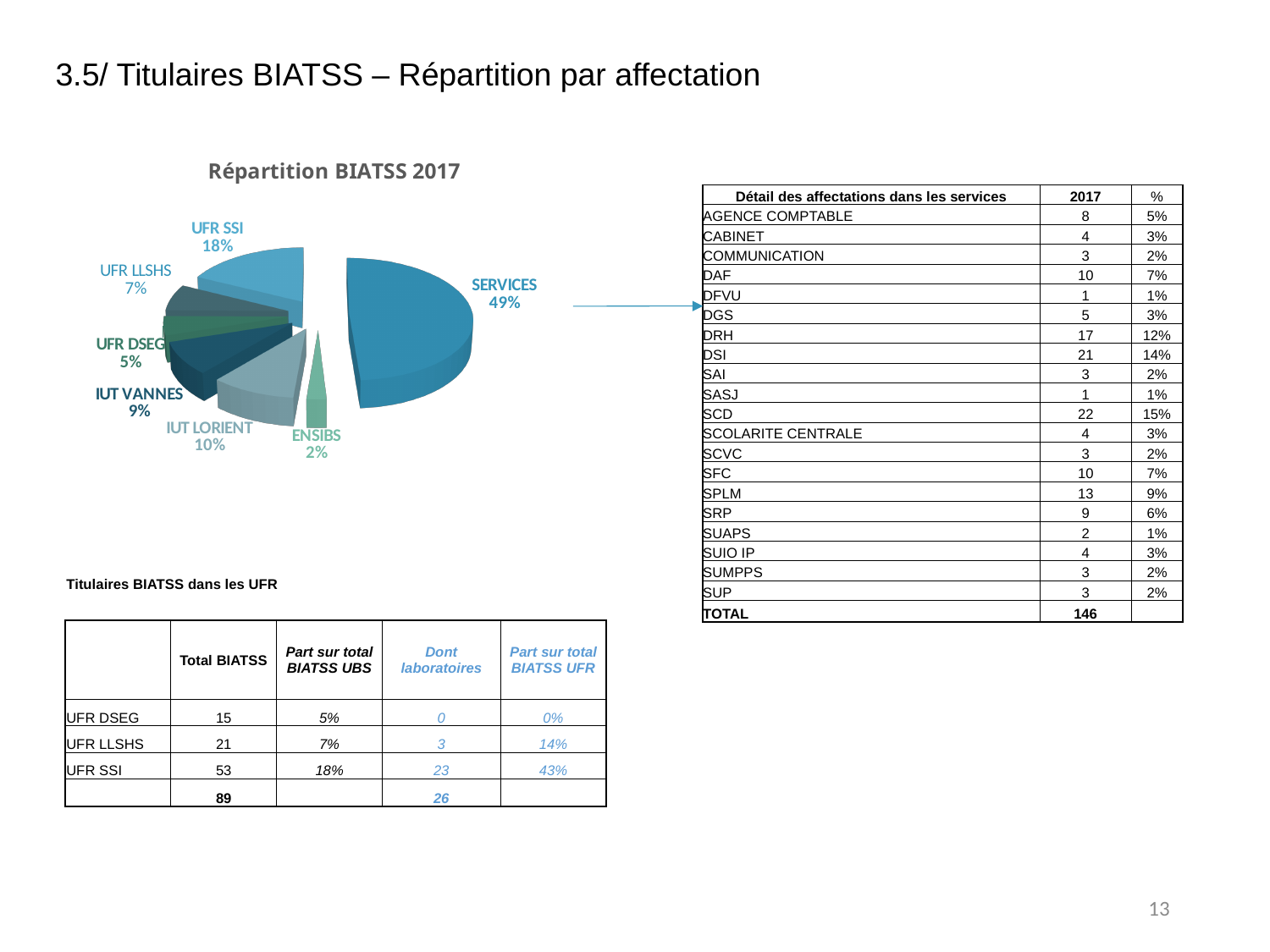
What kind of chart is shown on the slide? pie chart What is the difference in percentage points between UFR SSI and UFR LLSHS in the pie chart? 11% What share of the pie chart does SERVICES represent? 49% What is the combined share of IUT VANNES and IUT LORIENT in the pie chart? 19% What is the value shown for ENSIBS in the pie chart? 2% Which category has the largest slice in the pie chart? SERVICES What is the value shown for UFR SSI in the pie chart? 18% What is the value shown for IUT LORIENT in the pie chart? 10% Which category has the smallest slice in the pie chart? ENSIBS What is the title of the pie chart? Répartition BIATSS 2017 How many slices does the pie chart have? 7 Which is larger in the pie chart, IUT VANNES or UFR DSEG? IUT VANNES